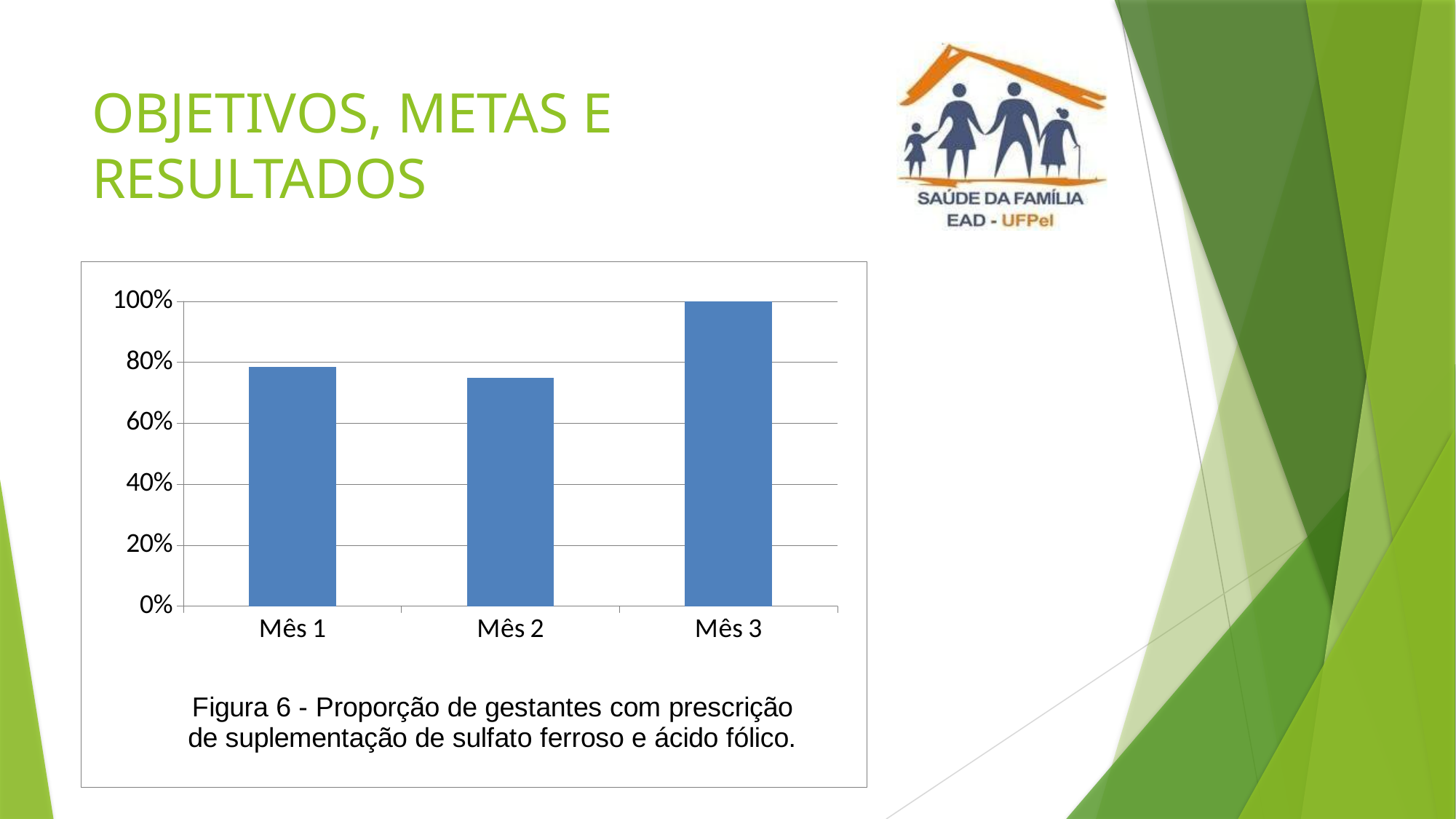
Which month has the highest value in the chart? Mês 3 How many categories (months) are plotted in the chart? 3 Which is larger, the value for Mês 1 or the value for Mês 3? Mês 3 What kind of chart is shown on the slide? bar chart Is the value for Mês 2 greater or less than 60%? greater Is the value for Mês 2 greater or less than 80%? less What is the highest value shown on the vertical axis of the chart? 100% What is the figure caption shown below the chart? Figura 6 - Proporção de gestantes com prescrição de suplementação de sulfato ferroso e ácido fólico. Is the value for Mês 1 greater or less than 60%? greater What is the value for Mês 3? 100% Which is larger, the value for Mês 3 or the value for Mês 2? Mês 3